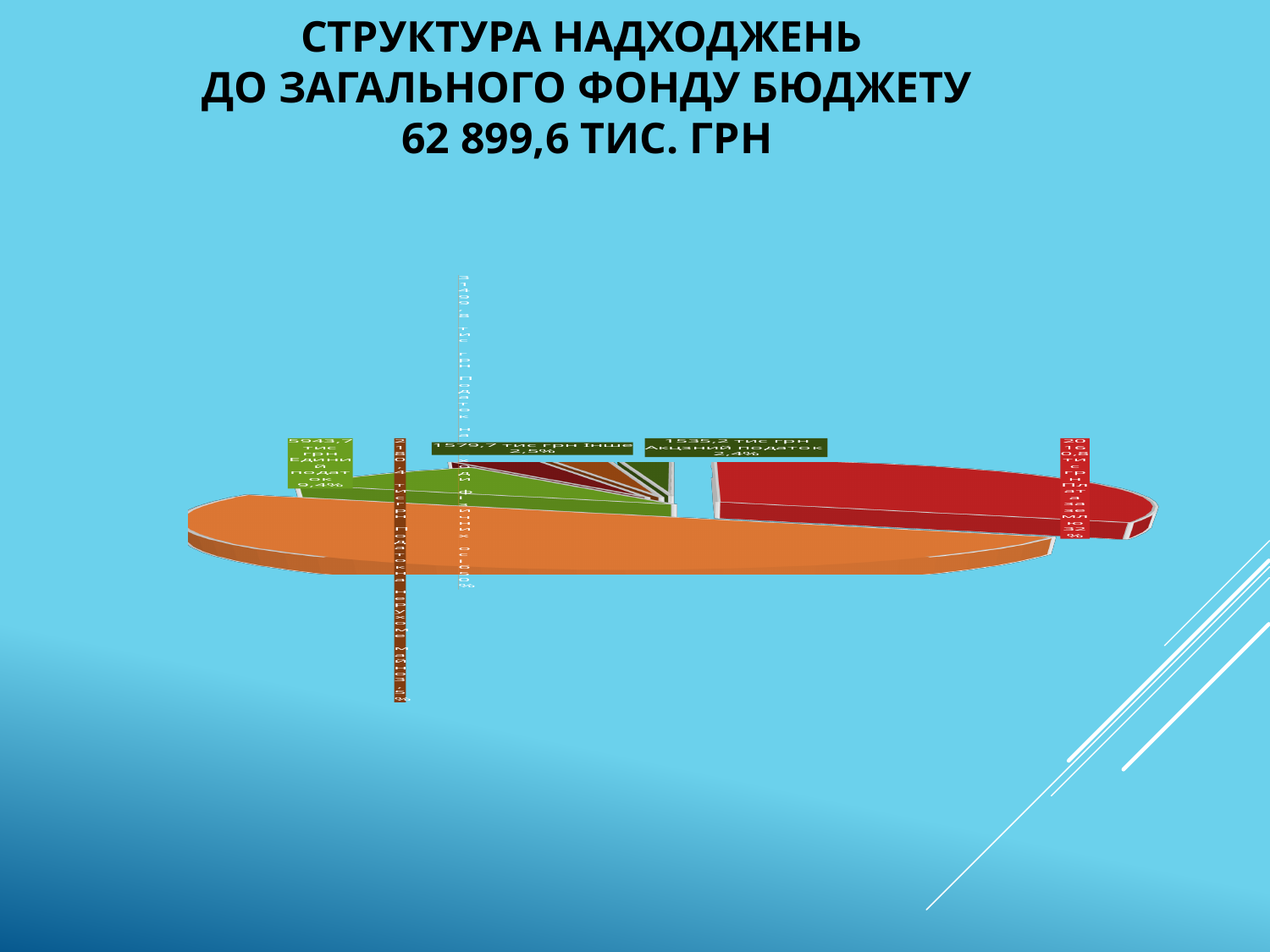
What share of the total does Акцизний податок represent? 2,4% What is the difference between the values for Єдиний податок and Інше? 4364,0 тис грн What is the value shown for Єдиний податок? 5943,7 тис грн What is the difference between the values for Плата за землю and Єдиний податок? 14217,1 тис грн What is the value shown for Плата за землю? 20160,8 тис грн What share of the total does Єдиний податок represent? 9,4% What share of the total does Плата за землю represent? 32% What total amount is stated in the chart title? 62 899,6 тис. грн What is the value shown for Інше? 1579,7 тис грн Which is larger, Плата за землю or Єдиний податок? Плата за землю What kind of chart is shown on the slide? pie chart What is the value shown for Акцизний податок? 1535,2 тис грн